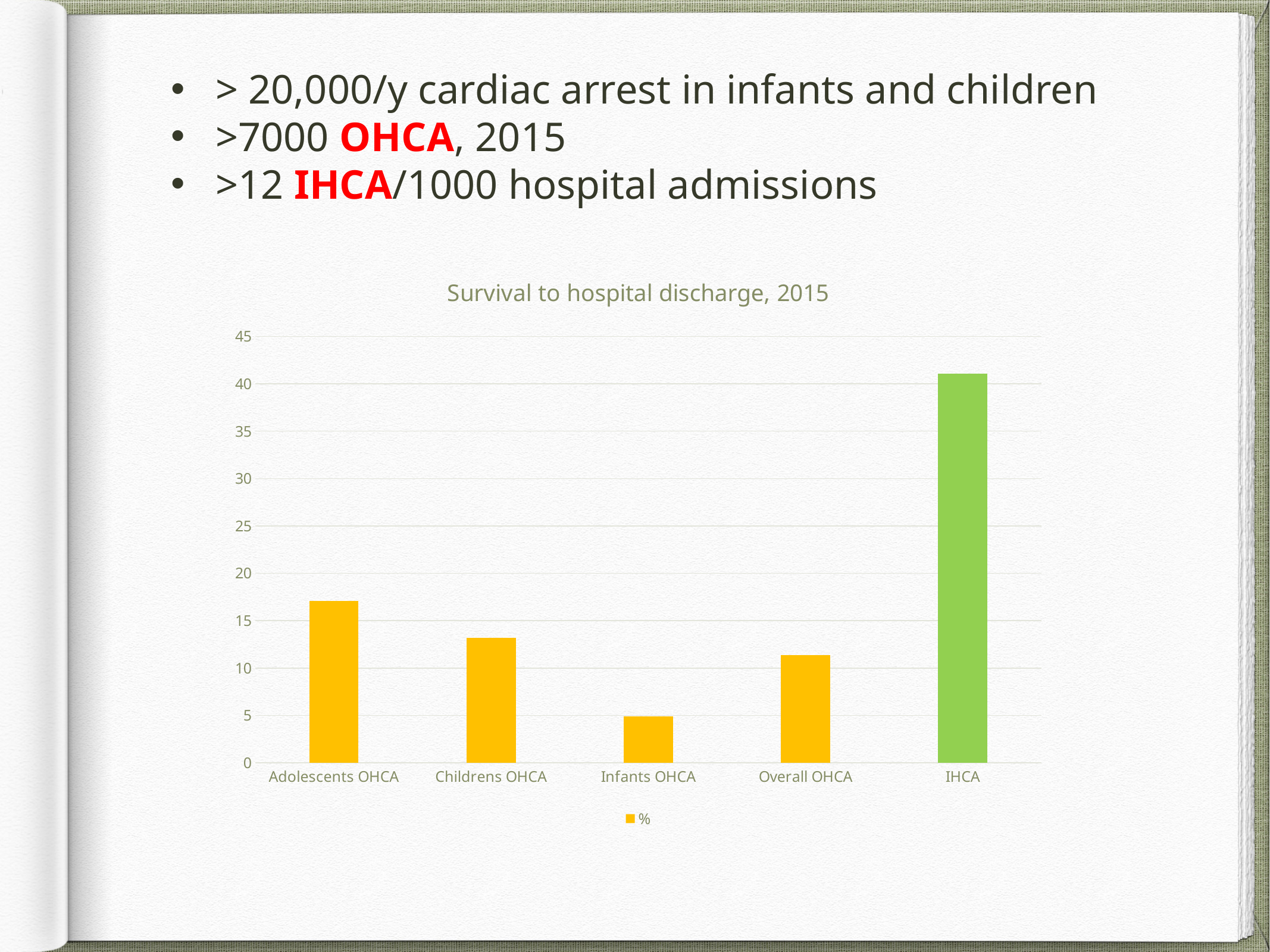
What kind of chart is shown on the slide? bar chart What label does the chart legend show for the series? % Which category has the lowest value in the chart? Infants OHCA Is the value for Infants OHCA greater or less than 10? less How many categories are shown on the x axis of the chart? 5 Is the value for IHCA greater or less than 40? greater What is the title of the chart? Survival to hospital discharge, 2015 Which is larger, the value for Adolescents OHCA or the value for Childrens OHCA? Adolescents OHCA Which category has the highest value in the chart? IHCA How many series does the chart legend list? 1 Is the value for Adolescents OHCA greater or less than 15? greater